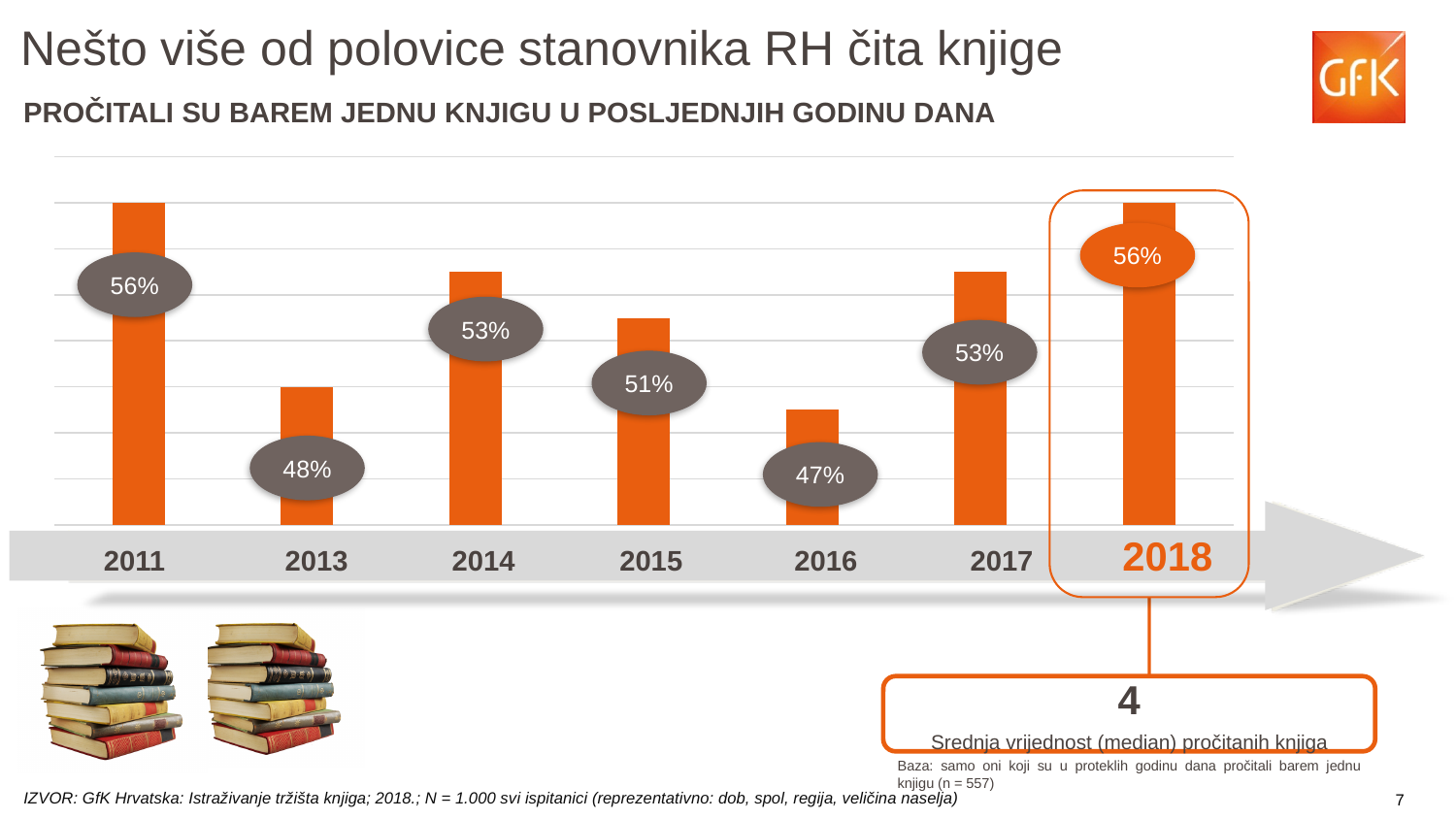
How many years are shown in the chart? 7 What is the highest percentage shown in the chart? 56% What is the difference in percentage points between 2018 and 2016? 9 percentage points What is the value shown for 2018? 56% Which year has the larger value, 2014 or 2015? 2014 What percentage of respondents read at least one book in 2011? 56% What is the value shown for 2016? 47% What is the difference in percentage points between 2011 and 2013? 8 percentage points What kind of chart is shown on the slide? Bar chart Which year has the lowest share of people who read at least one book? 2016 Do the values rise or fall from 2016 to 2018? Rise What is the value shown for 2013? 48%